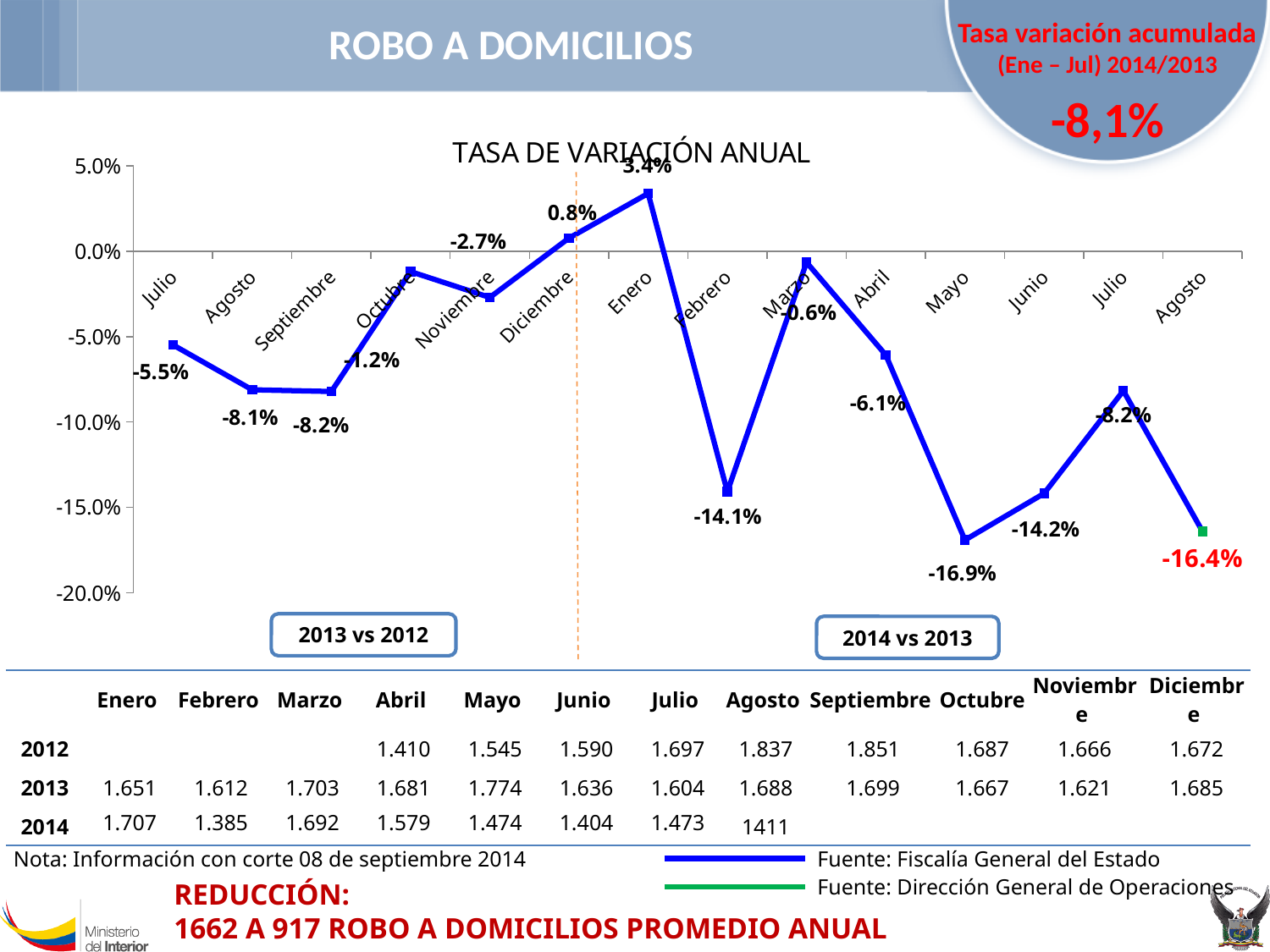
What kind of chart is shown under the title TASA DE VARIACIÓN ANUAL? line chart Which month has the lowest value on the TASA DE VARIACIÓN ANUAL chart? Mayo What is the value for Enero on the TASA DE VARIACIÓN ANUAL chart? 3.4% What is the value for the last point, Agosto in the 2014 vs 2013 section, on the TASA DE VARIACIÓN ANUAL chart? -16.4% On the TASA DE VARIACIÓN ANUAL chart, which is larger, the value for Noviembre or the value for Diciembre? Diciembre Which month has the highest value on the TASA DE VARIACIÓN ANUAL chart? Enero What is the value for Febrero on the TASA DE VARIACIÓN ANUAL chart? -14.1% On the TASA DE VARIACIÓN ANUAL chart, is the value for Febrero greater or less than -10.0%? less What is the value for Abril on the TASA DE VARIACIÓN ANUAL chart? -6.1% How many monthly data points are plotted on the TASA DE VARIACIÓN ANUAL line chart? 14 On the TASA DE VARIACIÓN ANUAL chart, does the line rise or fall from Enero to Febrero? fall On the TASA DE VARIACIÓN ANUAL chart, what is the difference between the values for Mayo and Junio? 2.7 percentage points